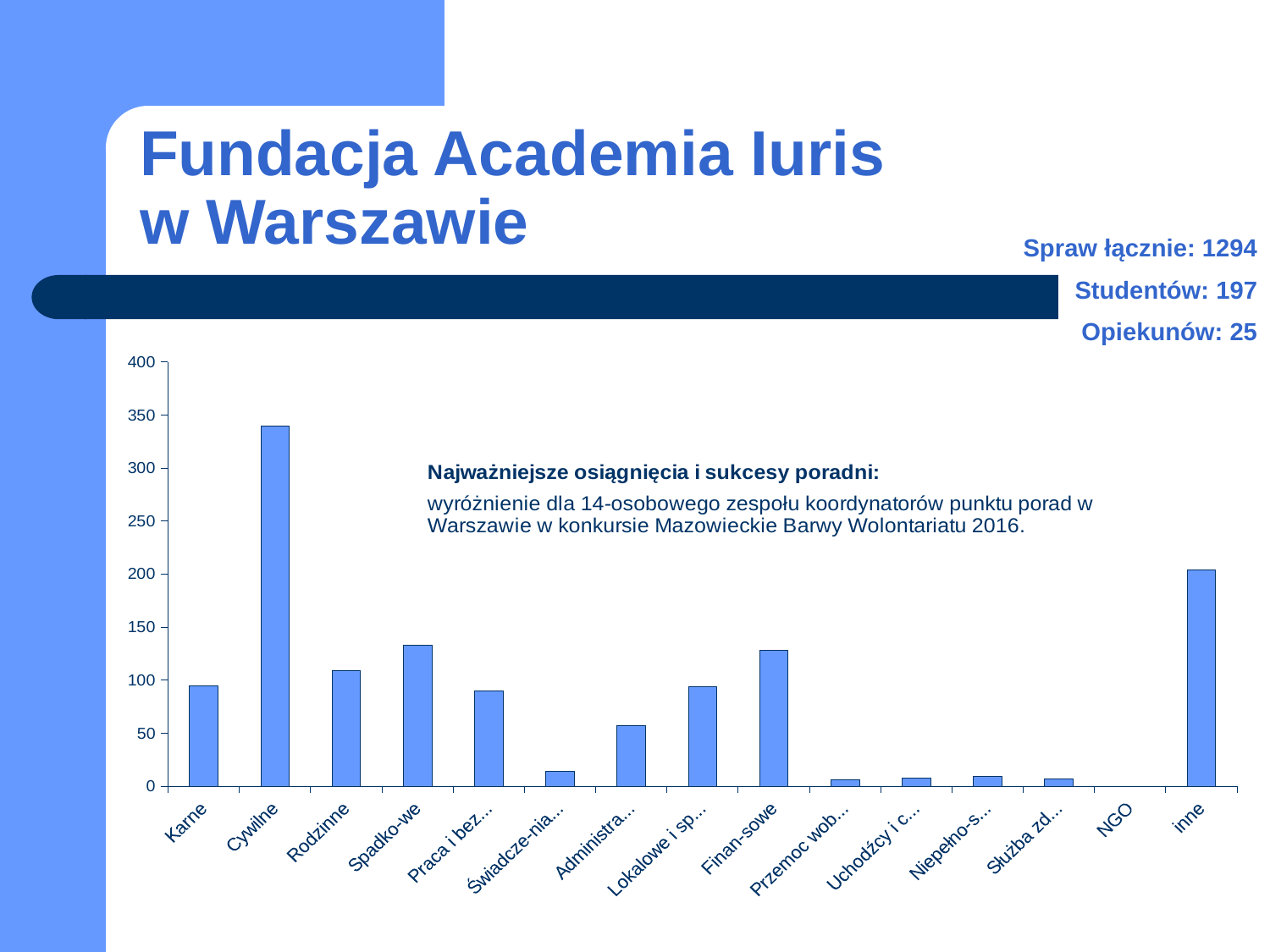
How many categories are shown on the x axis of the chart? 15 Is the value for Cywilne greater or less than 300? greater What is the highest value shown on the vertical axis of the chart? 400 What kind of chart is shown on the slide? bar chart Which category has the lowest value in the chart? NGO Which is larger, the value for Finan-sowe or the value for Administra...? Finan-sowe Which category has the highest bar in the chart? Cywilne Is the value for inne greater or less than 150? greater Is the value for Świadcze-nia... greater or less than 50? less Which is larger, the value for Cywilne or the value for inne? Cywilne